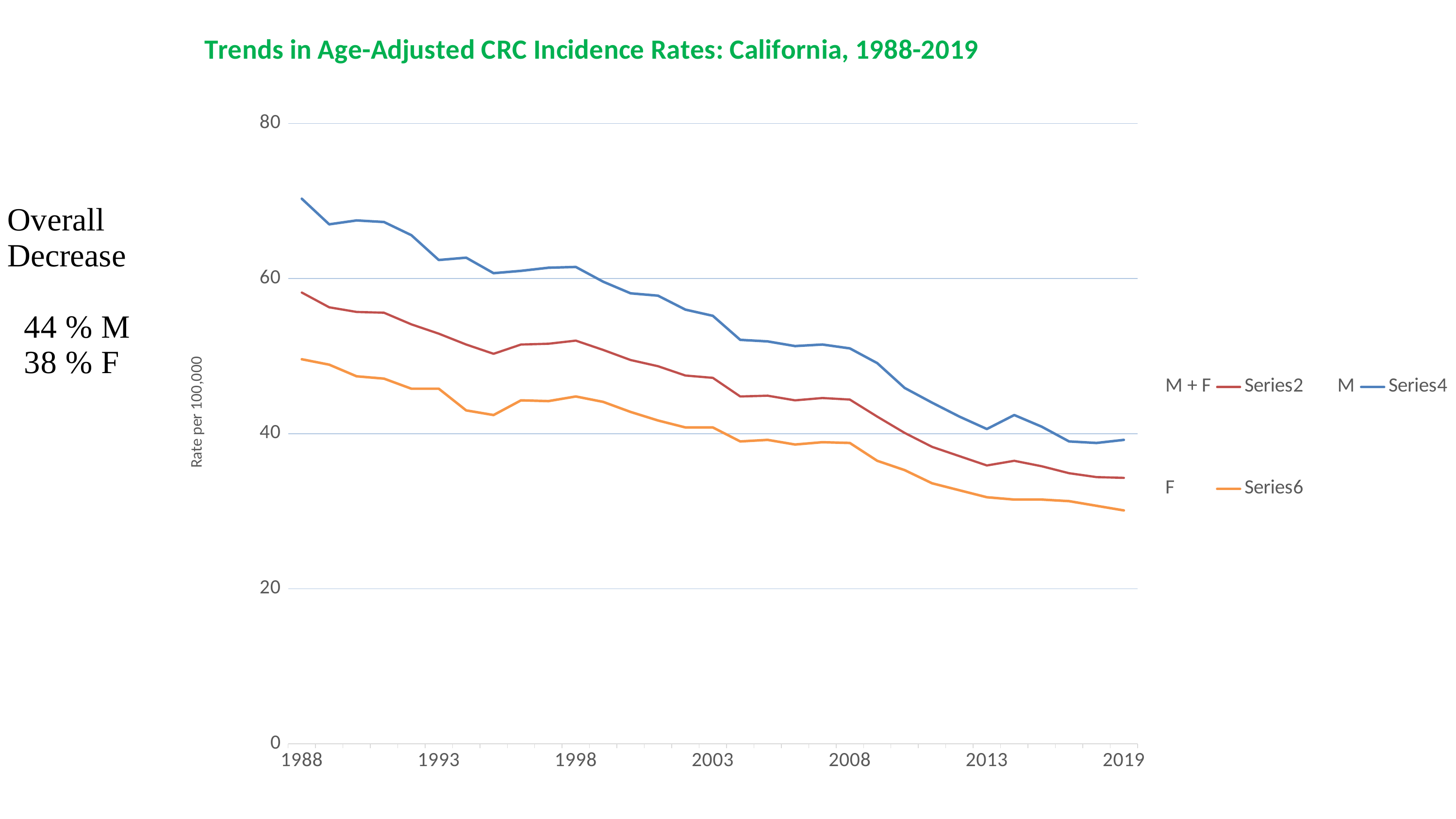
Is the value for M in 1988 greater or less than 60? greater How many series does the chart's legend list? 6 Which series has the lowest values throughout the chart? F What is the title of the chart? Trends in Age-Adjusted CRC Incidence Rates: California, 1988-2019 Which is larger in 1988, the value for M or the value for F? M Which series has the highest values throughout the chart? M Is the value for F in 2019 greater or less than 40? less What is the label on the vertical axis of the chart? Rate per 100,000 Do the incidence rates rise or fall from 1988 to 2019? fall Is the value for M in 2008 greater or less than 60? less What kind of chart is shown on the slide? line chart